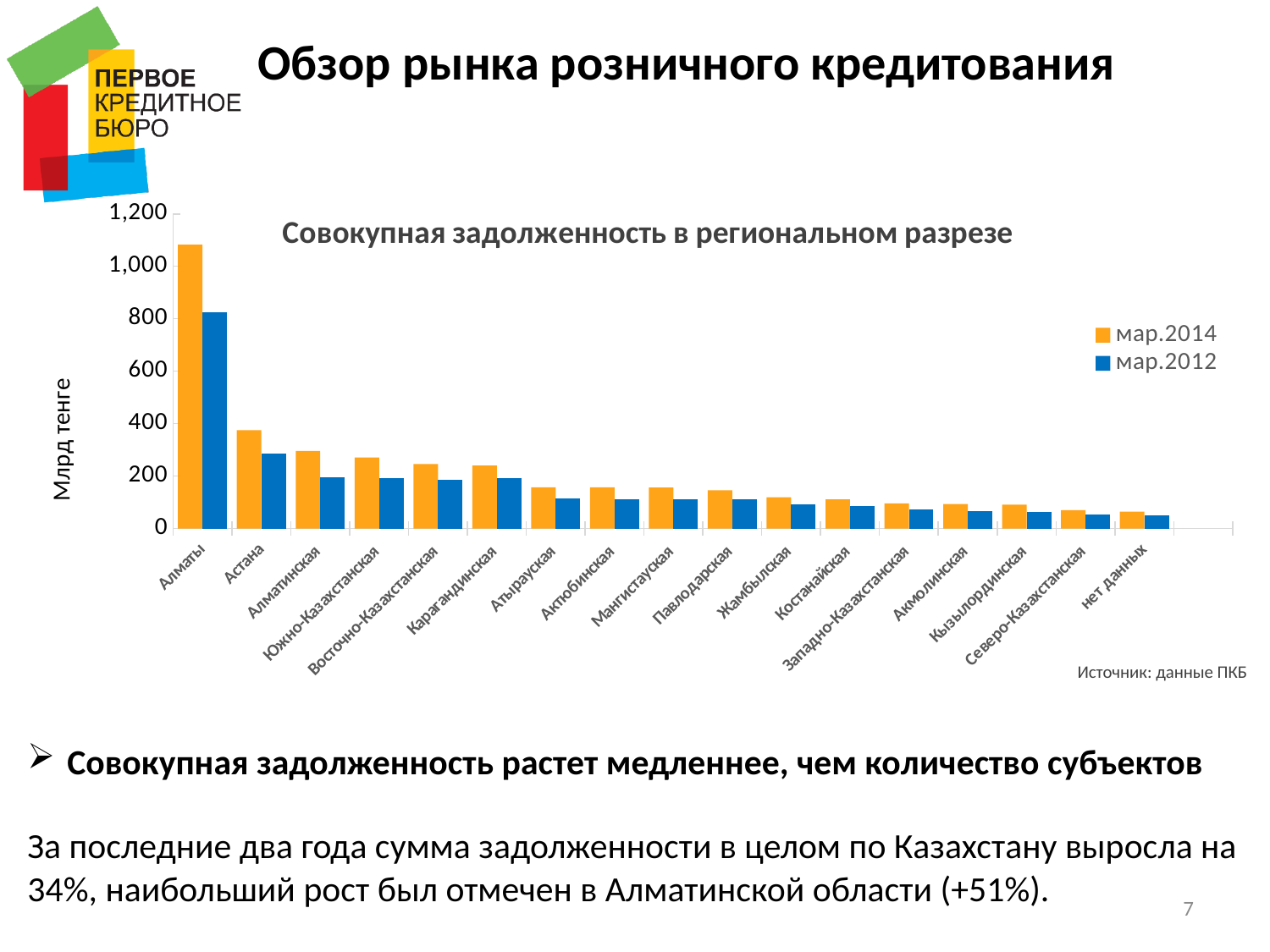
Which category has the highest value for мар.2014? Алматы How many categories are shown on the x axis of the chart? 17 Which series is shown in orange? мар.2014 What is the title of the chart? Совокупная задолженность в региональном разрезе Is the мар.2014 value for Атырауская greater or less than 200? less Is the мар.2014 value for Алматы greater or less than 1,000? greater Which is larger for мар.2014: Астана or Алматинская? Астана What kind of chart is shown on the slide? bar chart Is the мар.2014 value for Астана greater or less than 400? less Which category has the lowest value for мар.2012? нет данных How many series does the chart legend list? 2 Do the мар.2014 values rise or fall moving from left to right along the x axis? fall